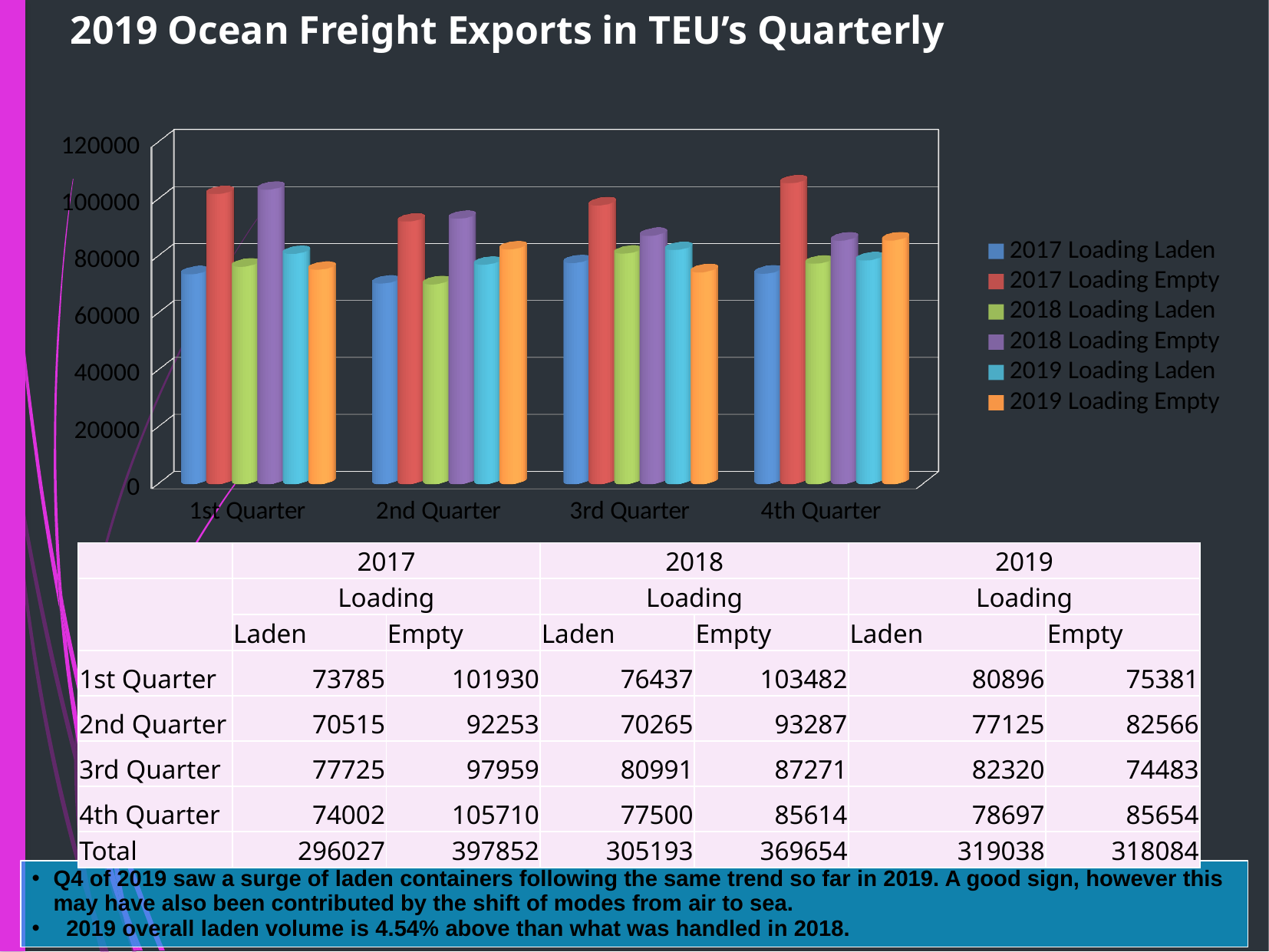
In which quarter is the 2018 Loading Laden value lowest? 2nd Quarter In the 1st Quarter, which is larger: 2019 Loading Laden or 2019 Loading Empty? 2019 Loading Laden What kind of chart is shown on the slide? Bar chart How many quarters are shown on the x axis of the chart? 4 What is the 2019 Loading Laden value for the 3rd Quarter? 82320 Does the 2017 Loading Empty value rise or fall from the 1st Quarter to the 2nd Quarter? Falls How many series does the chart legend list? 6 What colour represents 2019 Loading Empty in the chart legend? Orange What is the 2017 Loading Empty value for the 4th Quarter? 105710 In which quarter is the 2017 Loading Empty value highest? 4th Quarter What is the difference between the 2019 Loading Empty values for the 4th Quarter and the 3rd Quarter? 11171 Is the 2017 Loading Empty value for the 1st Quarter greater or less than 100000? greater